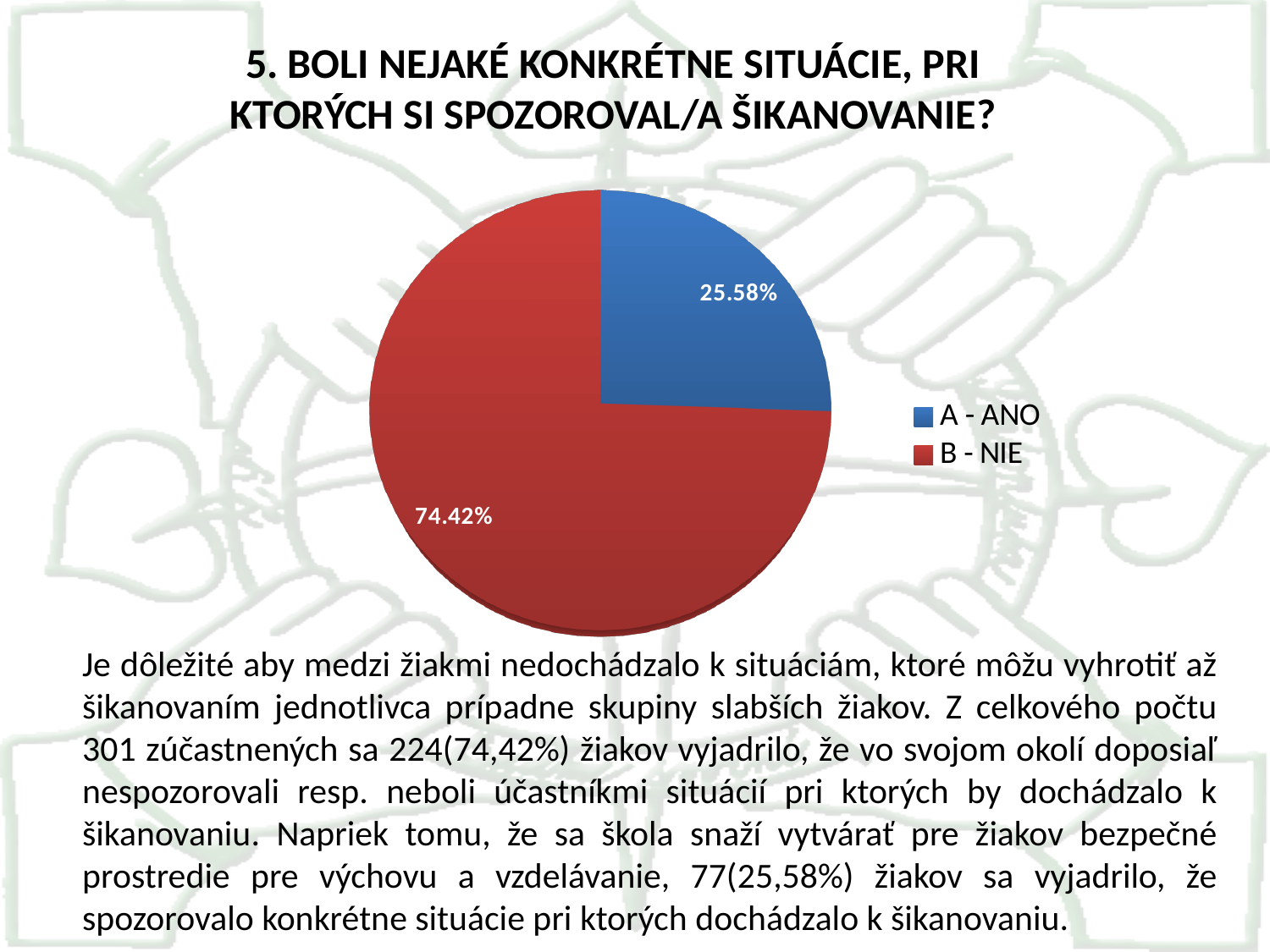
How many entries does the legend list? 2 What colour is the slice for B - NIE? red What is the difference in percentage points between the B - NIE slice and the A - ANO slice? 48.84 What share of the pie does the slice for B - NIE represent? 74.42% Which slice is larger, A - ANO or B - NIE? B - NIE What colour is the slice for A - ANO? blue What share of the pie does the slice for A - ANO represent? 25.58% What kind of chart is shown on the slide? pie chart How many slices does the pie chart have? 2 Which category has the largest slice of the pie? B - NIE Which category has the smallest slice of the pie? A - ANO